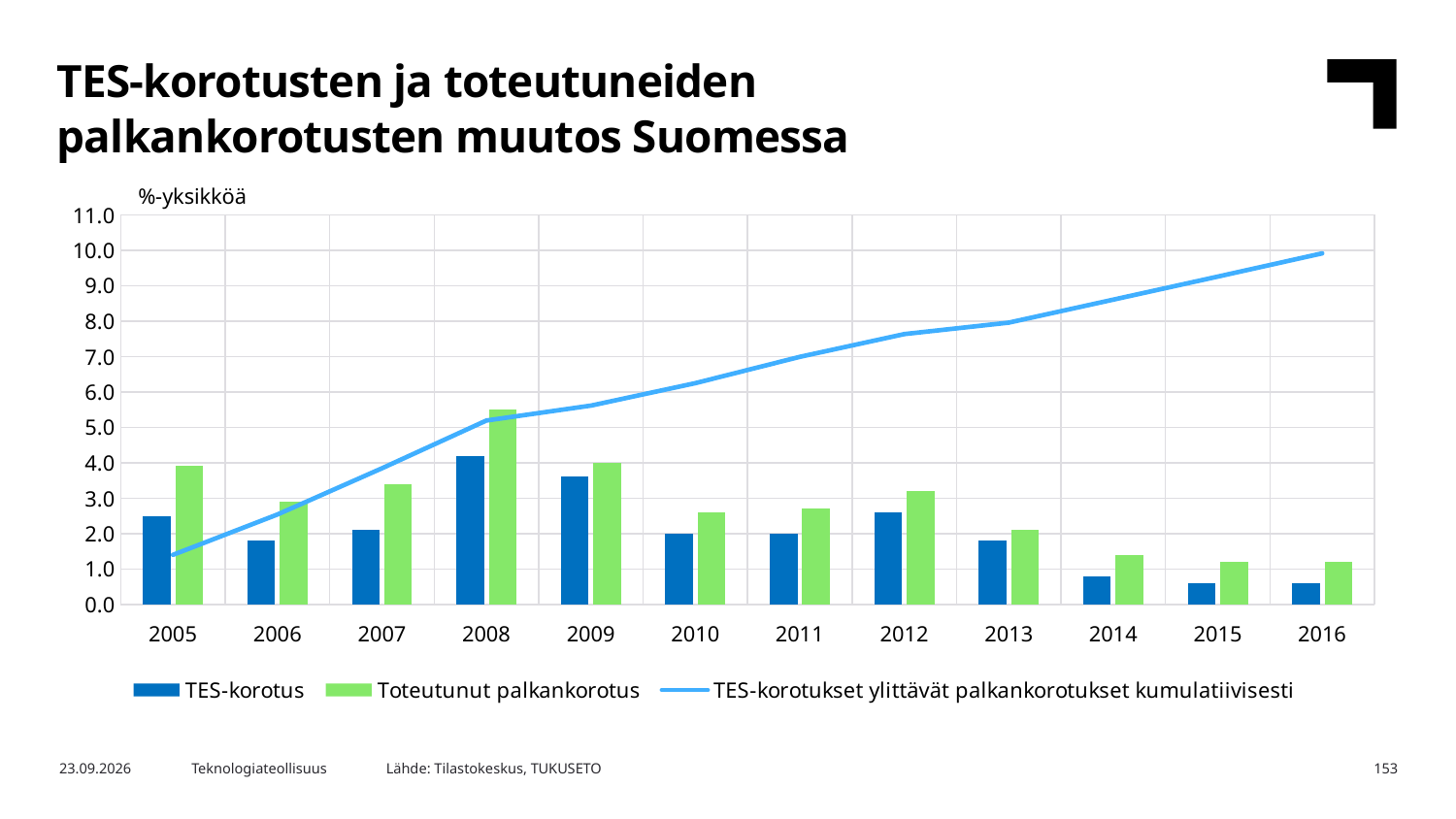
Is the value of the cumulative line in 2005 greater or less than 2.0? less In 2005, which is larger: TES-korotus or Toteutunut palkankorotus? Toteutunut palkankorotus How many series does the legend list? 3 How many years are shown on the x axis? 12 Is the value of the cumulative line in 2016 greater or less than 9.0? greater In which year is the Toteutunut palkankorotus bar highest? 2008 In which year is the TES-korotus bar highest? 2008 Is the TES-korotus value for 2014 greater or less than 1.0? less Does the line 'TES-korotukset ylittävät palkankorotukset kumulatiivisesti' rise or fall from 2005 to 2016? It rises What unit is shown above the y axis? %-yksikköä What kind of chart is shown on the slide? A bar chart combined with a line